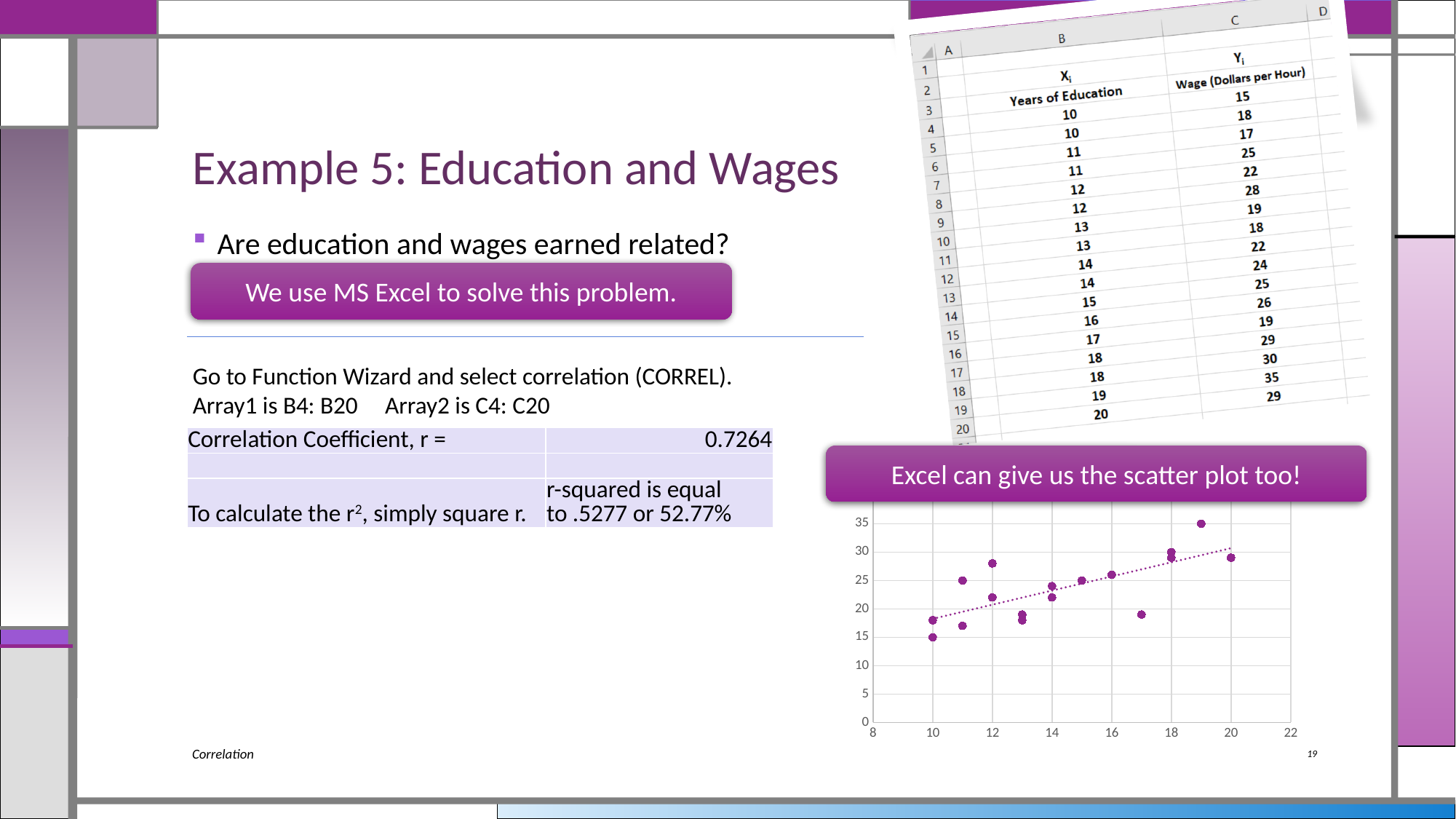
In the scatter plot, is the value of the point at x = 15 greater or less than 20? greater In the scatter plot, do the points generally rise or fall as x increases? rise In the scatter plot, at which x-value does the lowest point occur? 10 What is the highest tick value shown on the y-axis of the scatter plot? 35 In the scatter plot, which has the larger y-value: the point at x = 16 or the point at x = 17? x = 16 In the scatter plot, is the value of the point at x = 17 greater or less than 25? less In the scatter plot, what is the lowest y-value plotted? 15 In the scatter plot, what is the highest y-value plotted? 35 In the scatter plot, is the value of the point at x = 20 greater or less than 25? greater What kind of chart is shown at the bottom right of the slide? scatter plot In the scatter plot, which has the larger y-value: the point at x = 19 or the point at x = 20? x = 19 In the scatter plot, at which x-value does the highest point occur? 19